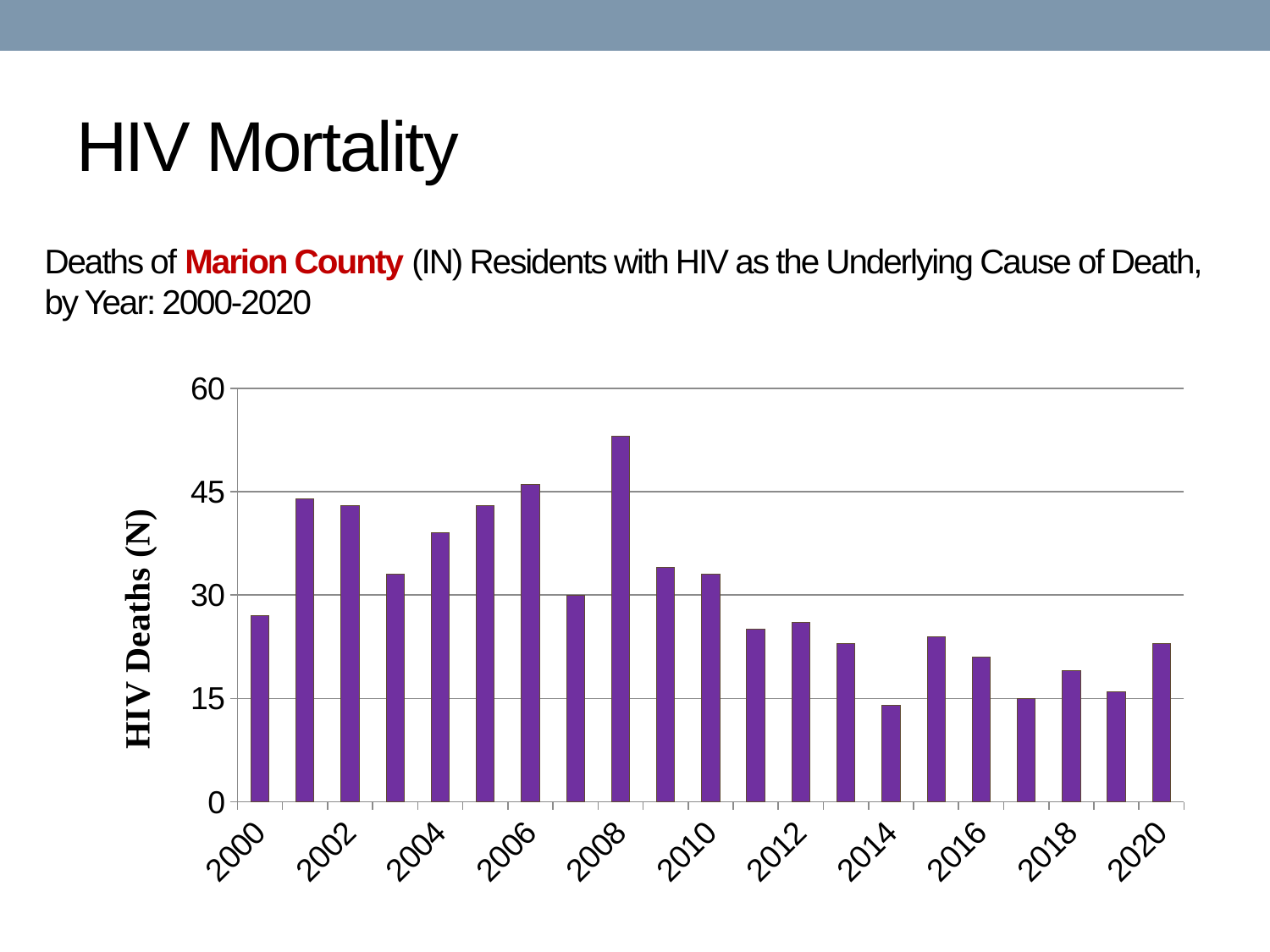
What is the label on the vertical axis of the chart? HIV Deaths (N) Which year has more HIV deaths, 2001 or 2003? 2001 Is the value for 2000 greater or less than 30? less What kind of chart is shown on the slide? bar chart Is the value for 2020 greater or less than 15? greater Is the value for 2014 greater or less than 15? less Which year has the highest number of HIV deaths? 2008 How many years are plotted on the chart? 21 Overall, do HIV deaths rise or fall from 2000 to 2020? fall Which year has the lowest number of HIV deaths? 2014